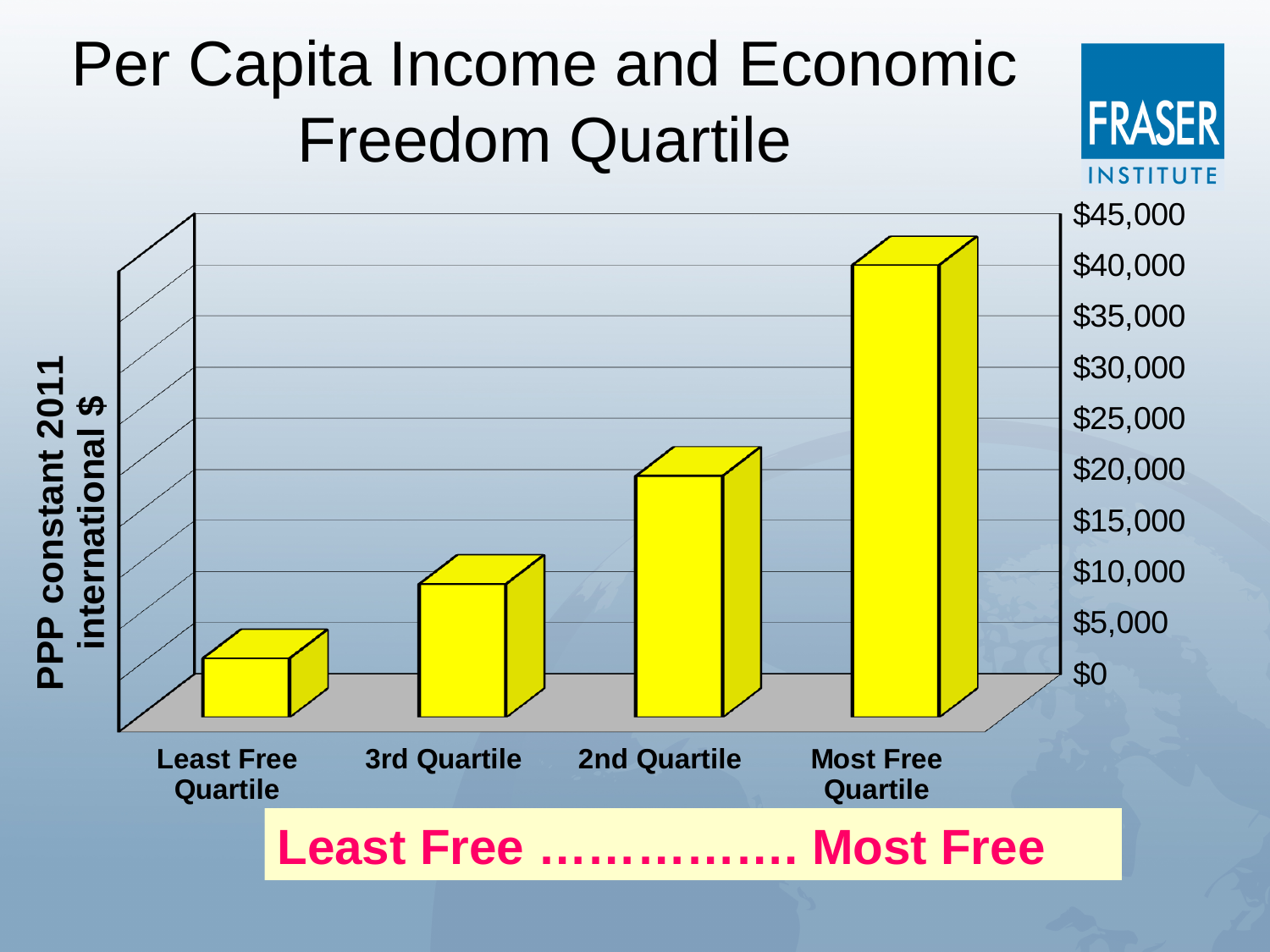
Which quartile has the lowest per capita income? Least Free Quartile What kind of chart is shown on the slide? bar chart Is the value for the Least Free Quartile greater or less than $10,000? less Do the values rise or fall moving from the Least Free Quartile to the Most Free Quartile along the x axis? rise Which quartile has the highest per capita income? Most Free Quartile Is the value for the 2nd Quartile greater or less than $25,000? less What is the title of the chart? Per Capita Income and Economic Freedom Quartile Is the value for the 3rd Quartile greater or less than $15,000? less Which has a higher per capita income, the 2nd Quartile or the 3rd Quartile? 2nd Quartile How many quartile categories are plotted on the chart? 4 What is the label on the vertical axis of the chart? PPP constant 2011 international $